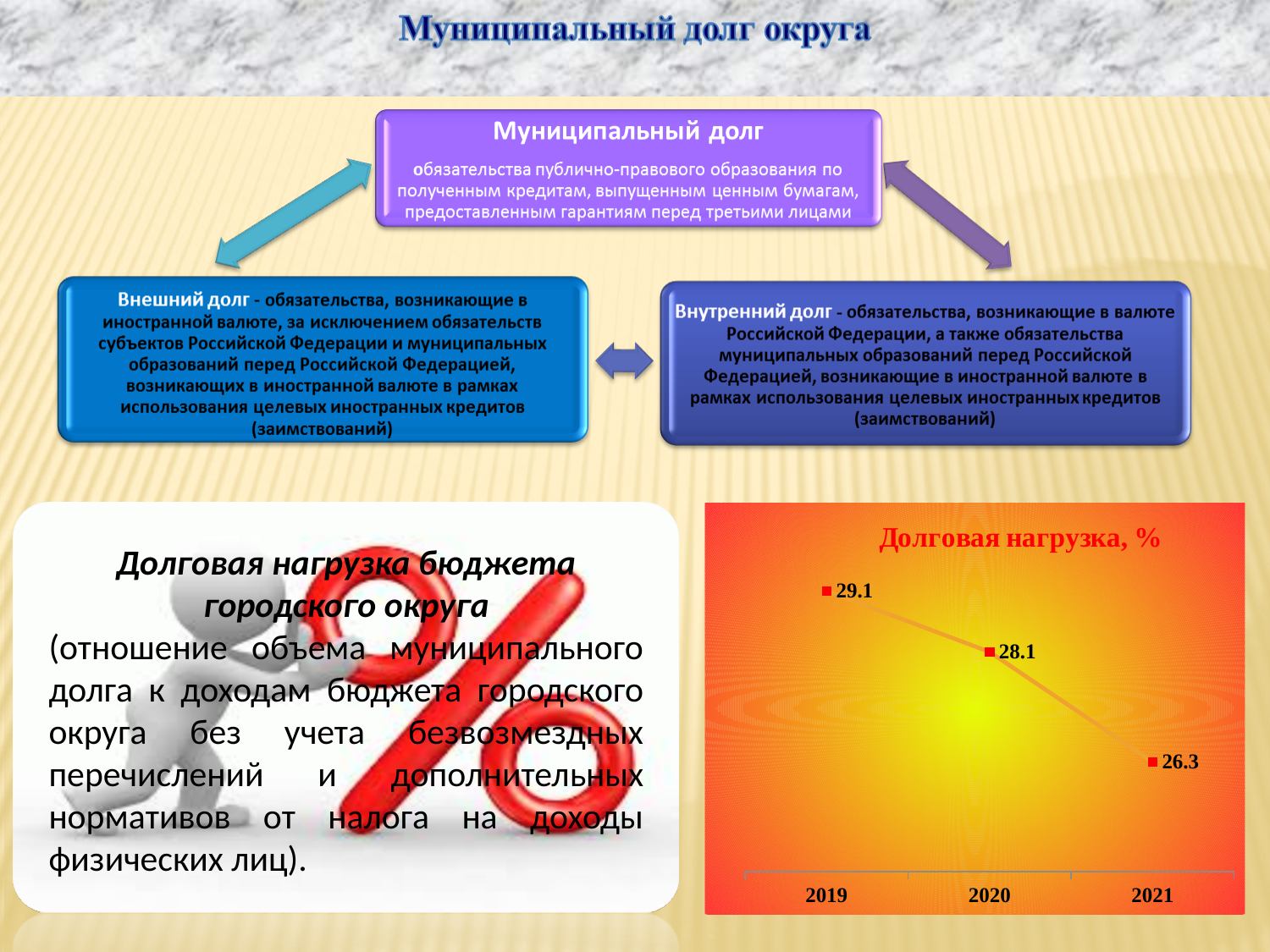
Do the values in the 'Долговая нагрузка, %' chart rise or fall from 2019 to 2021? fall How many years are plotted in the 'Долговая нагрузка, %' chart? 3 Which year has the lowest value in the 'Долговая нагрузка, %' chart? 2021 What is the title of the chart on the slide? Долговая нагрузка, % In the 'Долговая нагрузка, %' chart, which is larger: the value for 2020 or the value for 2021? 2020 What is the difference between the 2019 and 2020 values in the 'Долговая нагрузка, %' chart? 1.0 What is the value for 2019 in the 'Долговая нагрузка, %' chart? 29.1 Which year has the highest value in the 'Долговая нагрузка, %' chart? 2019 What is the difference between the 2019 and 2021 values in the 'Долговая нагрузка, %' chart? 2.8 What kind of chart is the 'Долговая нагрузка, %' chart? line chart What is the value for 2020 in the 'Долговая нагрузка, %' chart? 28.1 What is the value for 2021 in the 'Долговая нагрузка, %' chart? 26.3